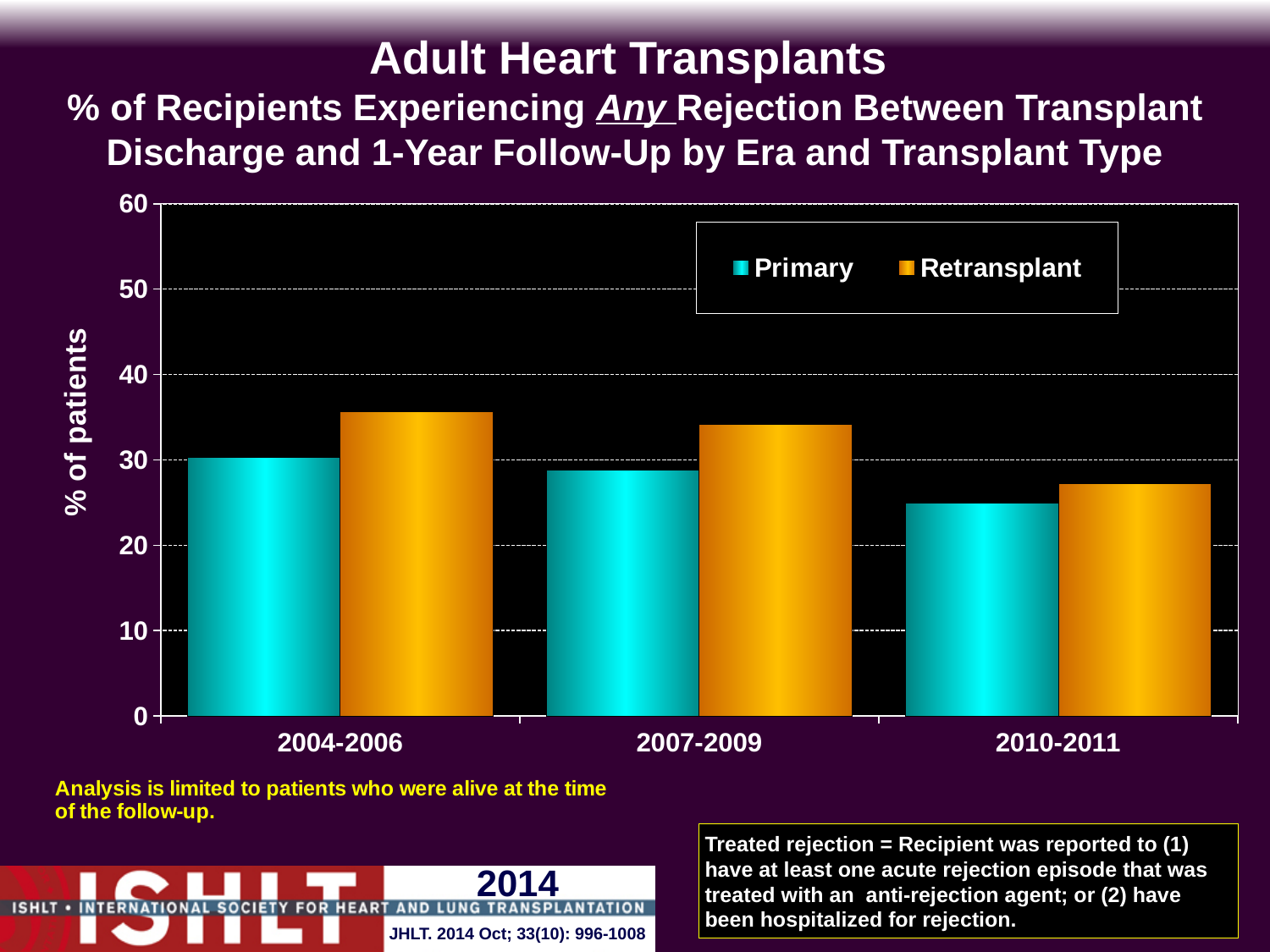
What is the y-axis label of the chart? % of patients How many series does the legend list? 2 Is the Retransplant value for 2004-2006 greater or less than 30? greater Is the Primary value for 2010-2011 greater or less than 30? less What kind of chart is shown on the slide? bar chart Do the Primary values rise or fall across the eras from 2004-2006 to 2010-2011? fall Which era has the lowest Primary value? 2010-2011 Is the Retransplant value for 2004-2006 greater or less than 40? less Which series is shown in orange in the legend? Retransplant How many era categories are shown on the x axis? 3 For 2004-2006, which is larger: the Primary value or the Retransplant value? Retransplant